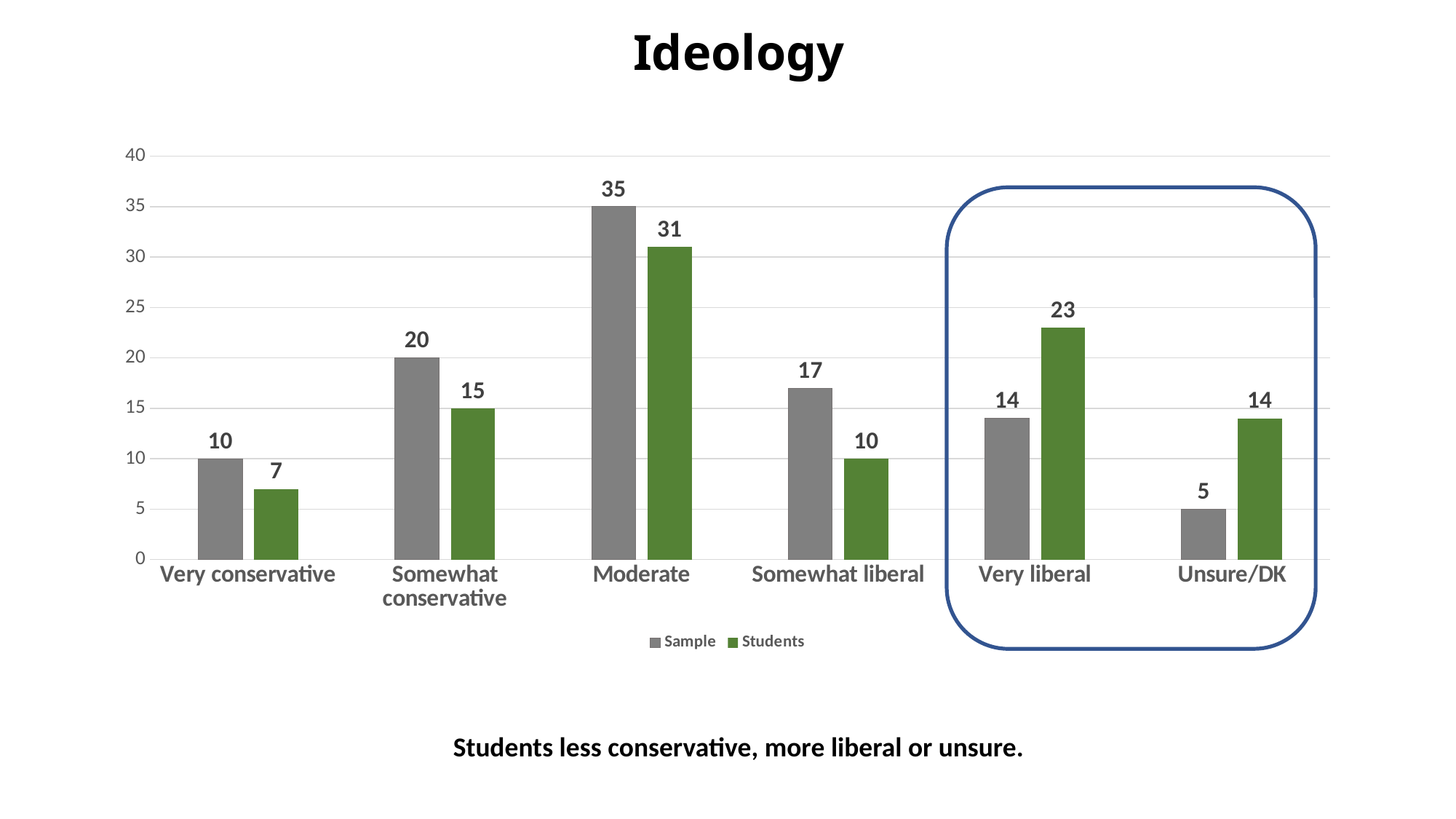
Which is larger for Somewhat conservative, the Sample value or the Students value? Sample What is the Students value for Very liberal? 23 How many categories are shown on the x axis? 6 Is the Students value for Moderate greater or less than 25? greater Which category has the highest Students value? Moderate What is the Students value for Unsure/DK? 14 What is the Sample value for Moderate? 35 What kind of chart is shown on the slide? Bar chart Which category has the lowest Sample value? Unsure/DK What is the difference between the Sample and Students values for Very liberal? 9 What is the title of the chart? Ideology How many series does the legend list? 2